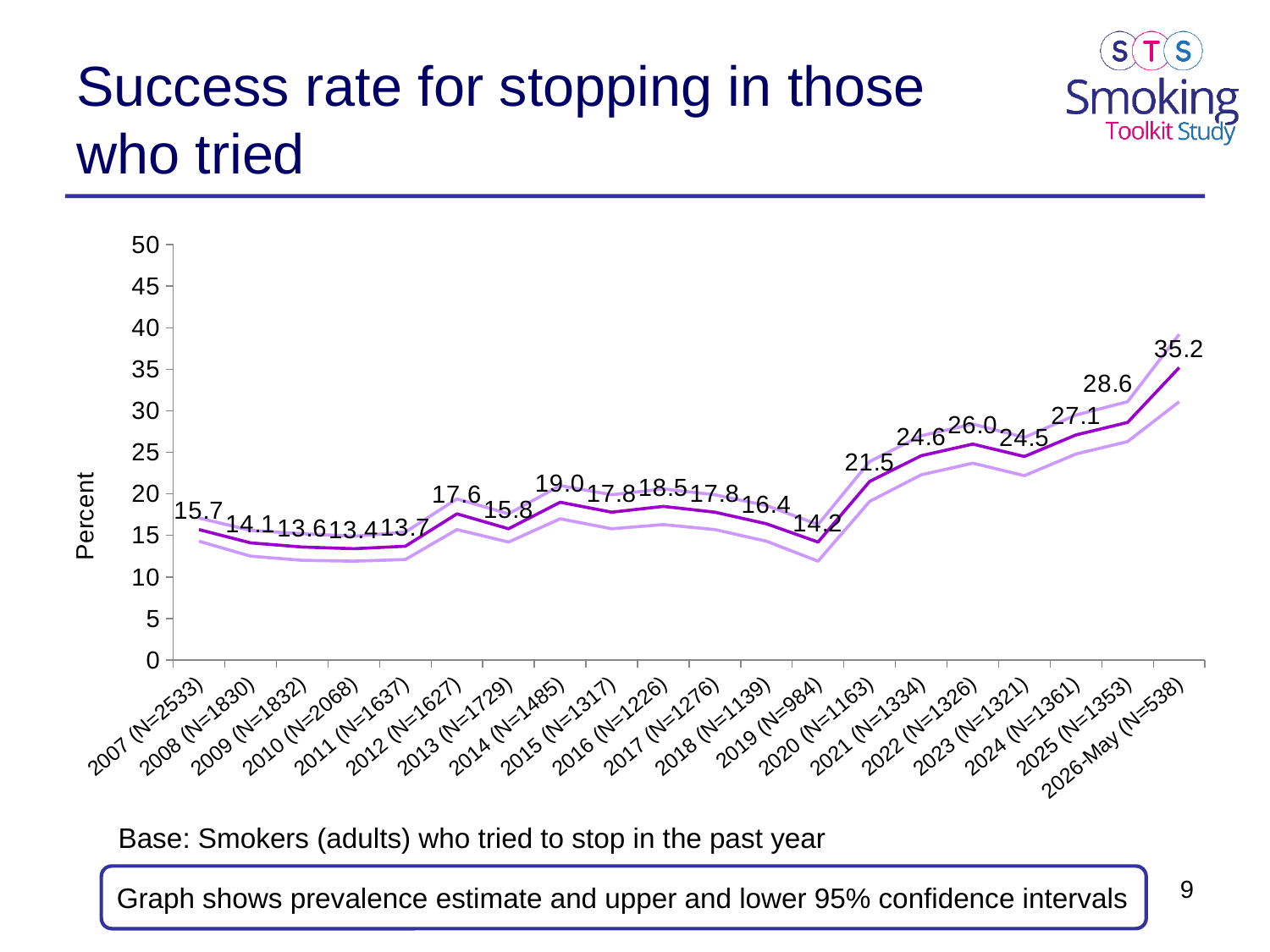
What is the success rate for stopping in 2007 (N=2533)? 15.7 Which year has the highest success rate for stopping? 2026-May (N=538) How many years (data points) are plotted on the x axis? 20 What kind of chart is shown on the slide? Line chart What is the success rate for stopping in 2020 (N=1163)? 21.5 Which year has the lowest success rate for stopping? 2010 (N=2068) Does the success rate rise or fall from 2020 (N=1163) to 2026-May (N=538)? Rise What is the success rate for stopping in 2026-May (N=538)? 35.2 Which year has a higher success rate, 2022 (N=1326) or 2023 (N=1321)? 2022 (N=1326) What is the label on the y axis of the chart? Percent Is the success rate for 2019 (N=984) greater or less than 15? less What is the difference between the success rate in 2025 (N=1353) and in 2024 (N=1361)? 1.5